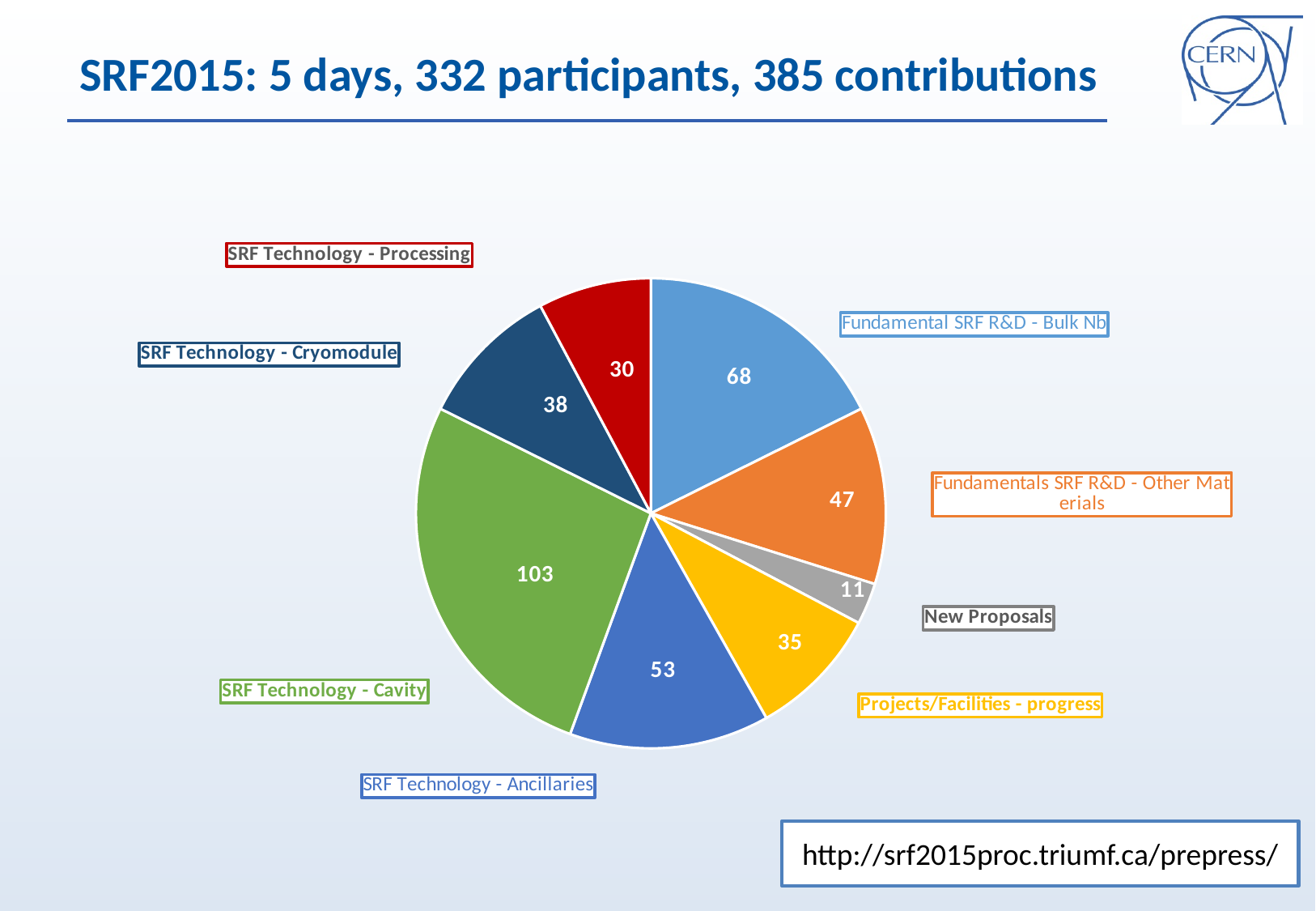
Which is larger, Fundamentals SRF R&D - Other Materials or Projects/Facilities - progress? Fundamentals SRF R&D - Other Materials What is the difference between SRF Technology - Cavity and SRF Technology - Ancillaries? 50 Which category has the largest slice? SRF Technology - Cavity What is the total of all slices in the pie chart? 385 Which category has the smallest slice? New Proposals What is the value for SRF Technology - Cryomodule? 38 What is the value for SRF Technology - Cavity? 103 What kind of chart is shown on the slide? pie chart What is the value for Fundamental SRF R&D - Bulk Nb? 68 What is the value for New Proposals? 11 What colour is the slice for SRF Technology - Processing? red How many slices does the pie chart have? 8